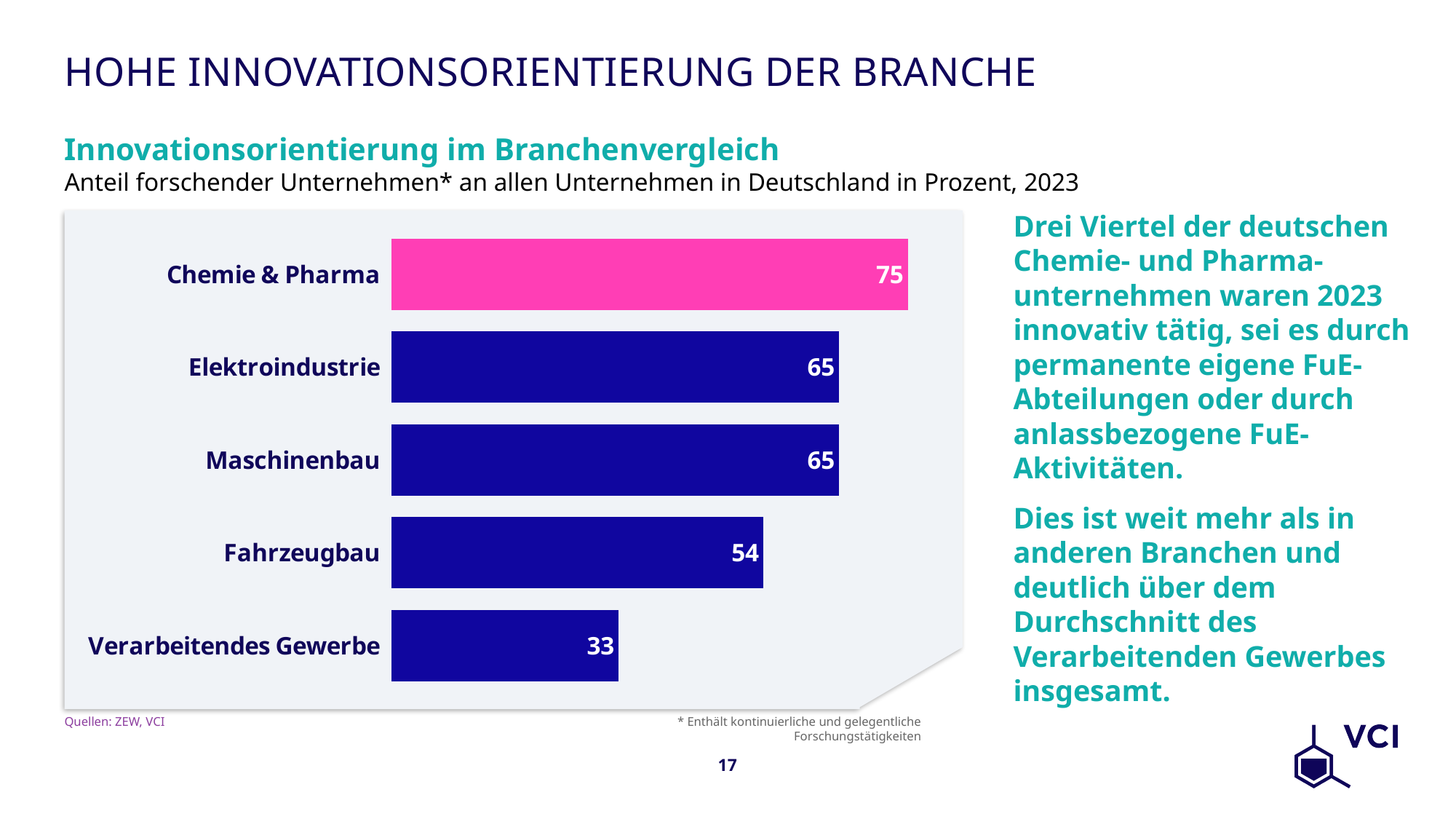
Which category's bar is coloured pink rather than dark blue? Chemie & Pharma What is the value for Verarbeitendes Gewerbe? 33 Which category has the highest value? Chemie & Pharma What is the difference between the values for Chemie & Pharma and Verarbeitendes Gewerbe? 42 What is the value for Fahrzeugbau? 54 Which category has the lowest value? Verarbeitendes Gewerbe What is the difference between the values for Maschinenbau and Fahrzeugbau? 11 Which is larger, the value for Fahrzeugbau or the value for Maschinenbau? Maschinenbau What kind of chart is shown on the slide? Bar chart What is the value for Chemie & Pharma? 75 How many categories are shown in the chart? 5 What is the value for Elektroindustrie? 65